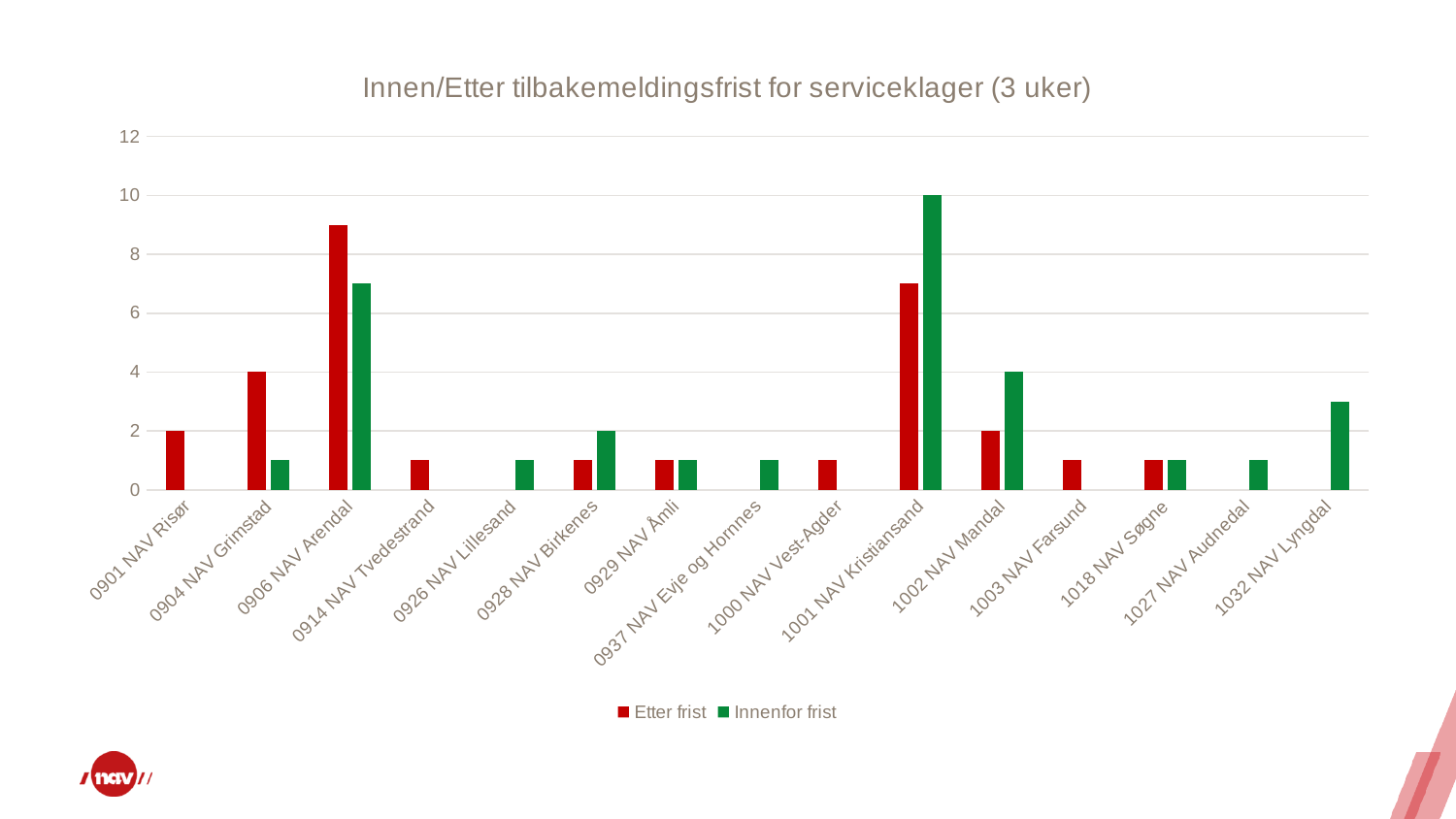
What is the title of the chart? Innen/Etter tilbakemeldingsfrist for serviceklager (3 uker) What type of chart is shown on the slide? Bar chart What is the Innenfor frist value for 1001 NAV Kristiansand? 10 How many series does the legend list? 2 How many NAV offices (categories) are shown on the x axis? 15 Is the Etter frist value for 0906 NAV Arendal greater or less than 8? greater Which office has the highest Innenfor frist value? 1001 NAV Kristiansand For 1001 NAV Kristiansand, which is larger: Etter frist or Innenfor frist? Innenfor frist What is the Etter frist value for 0901 NAV Risør? 2 What is the difference between the Innenfor frist values for 1001 NAV Kristiansand and 1002 NAV Mandal? 6 Which office has the highest Etter frist value? 0906 NAV Arendal What is the Etter frist value for 0904 NAV Grimstad? 4